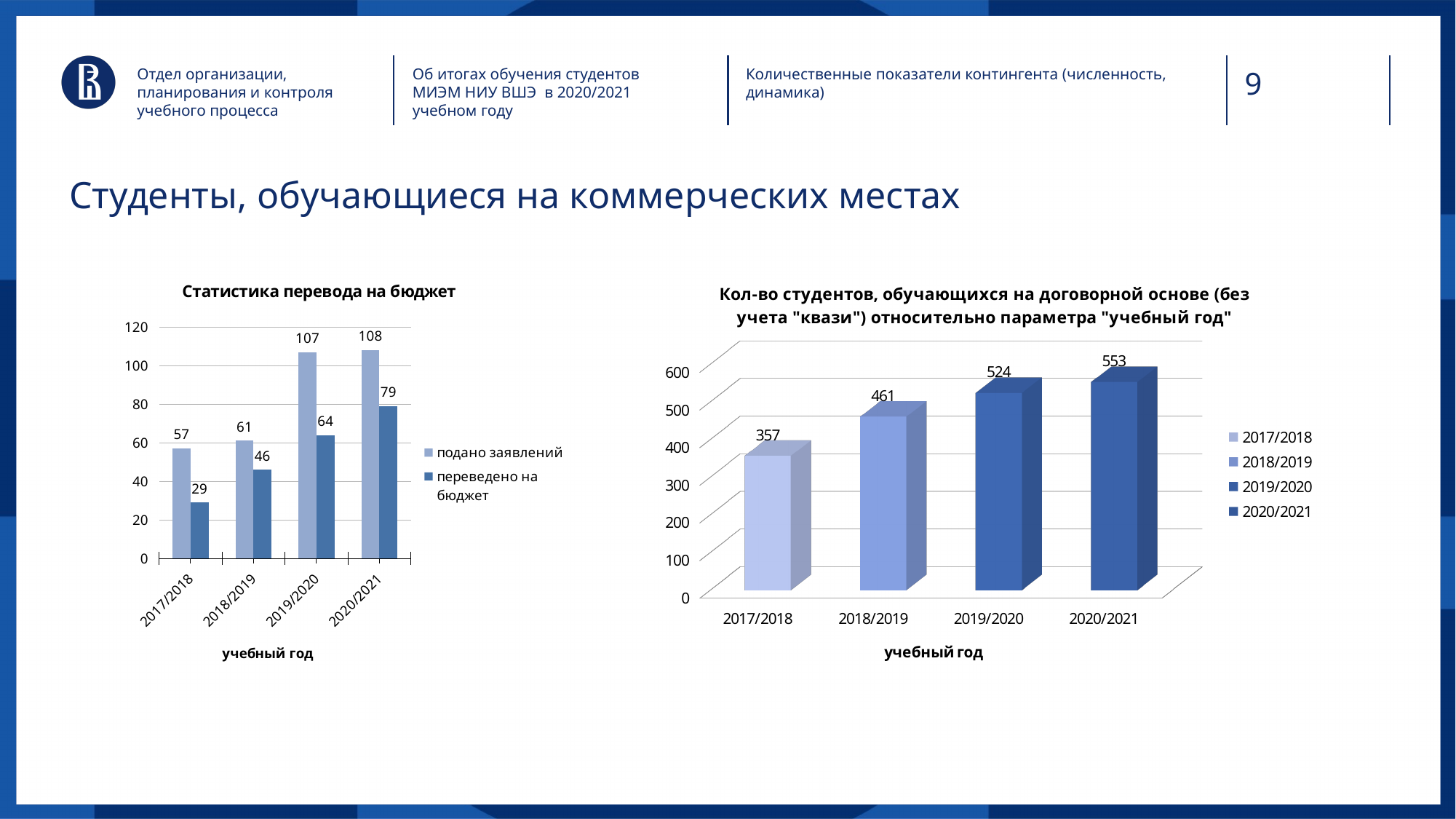
In the chart on the right, how many academic years are shown on the x axis? 4 In the chart "Статистика перевода на бюджет", what is the value of "переведено на бюджет" for 2017/2018? 29 In the chart "Статистика перевода на бюджет", does the value of "переведено на бюджет" rise or fall from 2017/2018 to 2020/2021? rise What type of chart is the chart on the right? bar chart In the chart "Статистика перевода на бюджет", what is the value of "подано заявлений" for 2019/2020? 107 In the chart on the right, which is larger: the value for 2019/2020 or the value for 2018/2019? 2019/2020 In the chart on the right, what is the number of students for 2018/2019? 461 In the chart on the right, what is the difference between the values for 2020/2021 and 2017/2018? 196 In the chart "Статистика перевода на бюджет", how many series does the legend list? 2 In the chart "Статистика перевода на бюджет", what is the difference between "подано заявлений" and "переведено на бюджет" in 2020/2021? 29 In the chart on the right, which academic year has the lowest value? 2017/2018 In the chart "Статистика перевода на бюджет", which academic year has the highest value of "переведено на бюджет"? 2020/2021